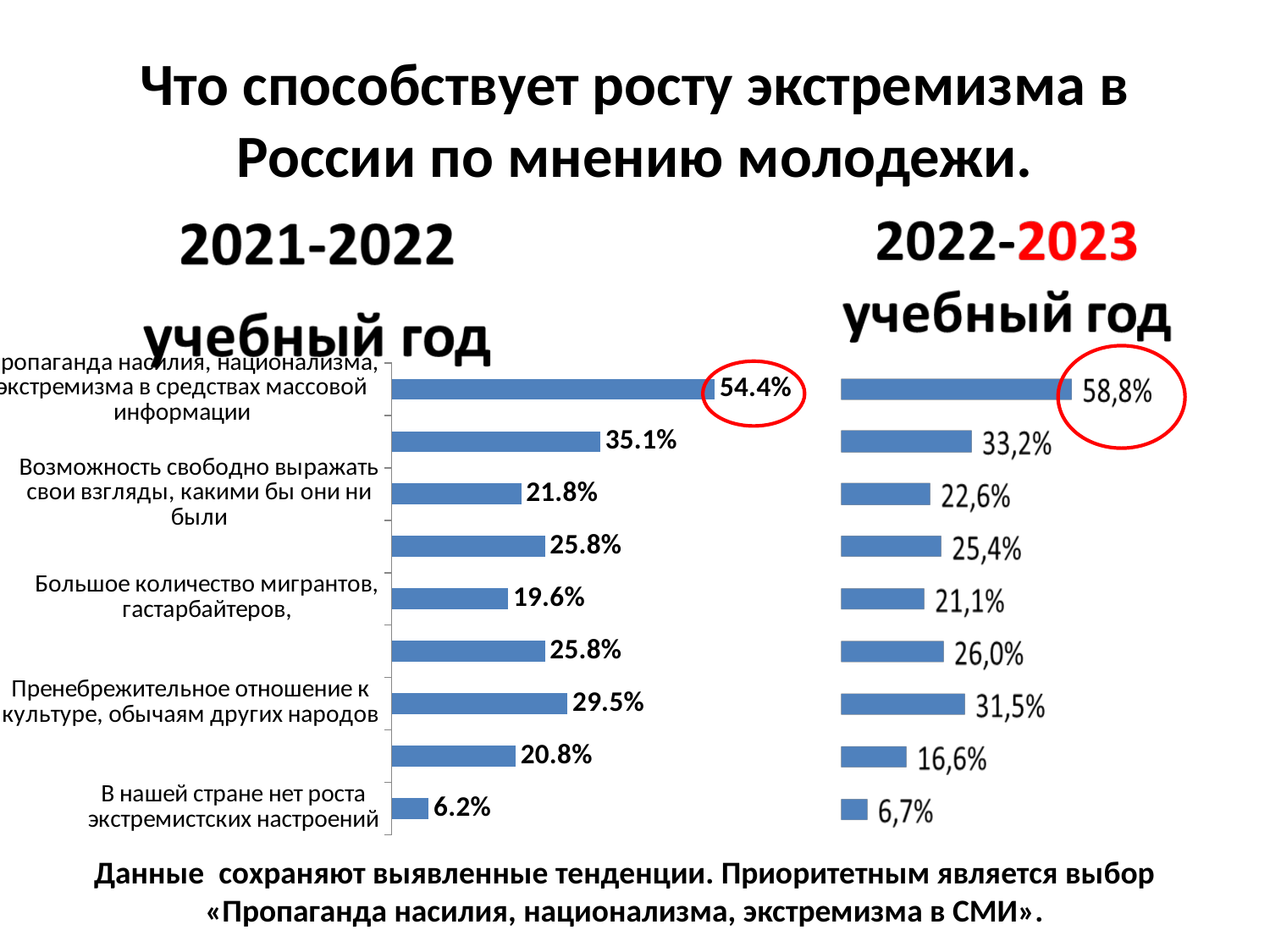
On the 2021-2022 учебный год chart, how many bars are plotted? 9 On the 2022-2023 учебный год chart, what is the value of the bottom bar? 6,7% On the 2021-2022 учебный год chart, what is the value for «Пропаганда насилия, национализма, экстремизма в средствах массовой информации»? 54.4% On the 2022-2023 учебный год chart, which value is circled in red? 58,8% On the 2021-2022 учебный год chart, which category has the highest value? Пропаганда насилия, национализма, экстремизма в средствах массовой информации On the 2021-2022 учебный год chart, what is the difference between «Пренебрежительное отношение к культуре, обычаям других народов» (29.5%) and «Большое количество мигрантов, гастарбайтеров» (19.6%)? 9.9 percentage points On the 2021-2022 учебный год chart, which category has the lowest value? В нашей стране нет роста экстремистских настроений On the 2021-2022 учебный год chart, what is the value for «Возможность свободно выражать свои взгляды, какими бы они ни были»? 21.8% What type of chart is used on this slide? Bar chart On the 2021-2022 учебный год chart, what is the value for «Большое количество мигрантов, гастарбайтеров»? 19.6% Which chart shows the larger value for its top bar: 2021-2022 учебный год (54.4%) or 2022-2023 учебный год (58,8%)? 2022-2023 учебный год On the 2022-2023 учебный год chart, what is the value of the top bar? 58,8%